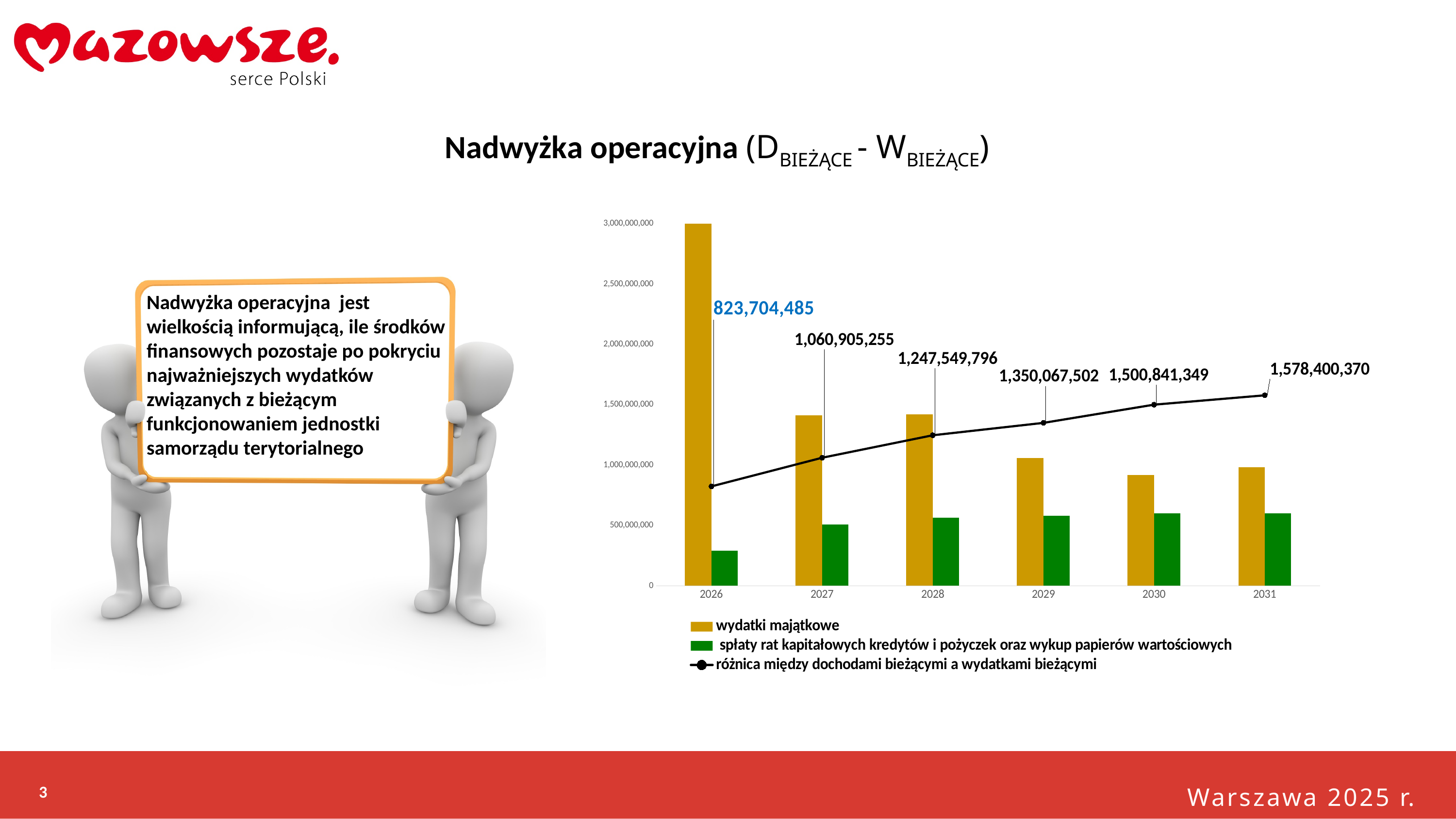
Which is larger: the line series value for 2028 or for 2030? 2030 In which year is the line series 'różnica między dochodami bieżącymi a wydatkami bieżącymi' highest? 2031 What is the value of the line series 'różnica między dochodami bieżącymi a wydatkami bieżącymi' for 2026? 823,704,485 Is the value of the 'wydatki majątkowe' bar for 2030 greater or less than 1,000,000,000? less In which year is the 'spłaty rat kapitałowych kredytów i pożyczek oraz wykup papierów wartościowych' bar the lowest? 2026 What is the difference between the line series values for 2031 and 2026? 754,695,885 In which year is the 'wydatki majątkowe' bar the highest? 2026 What is the value of the line series 'różnica między dochodami bieżącymi a wydatkami bieżącymi' for 2031? 1,578,400,370 How many years are shown on the x axis of the chart? 6 How many series does the chart legend list? 3 Does the line series 'różnica między dochodami bieżącymi a wydatkami bieżącymi' rise or fall from 2026 to 2031? rise What is the value of the line series 'różnica między dochodami bieżącymi a wydatkami bieżącymi' for 2029? 1,350,067,502